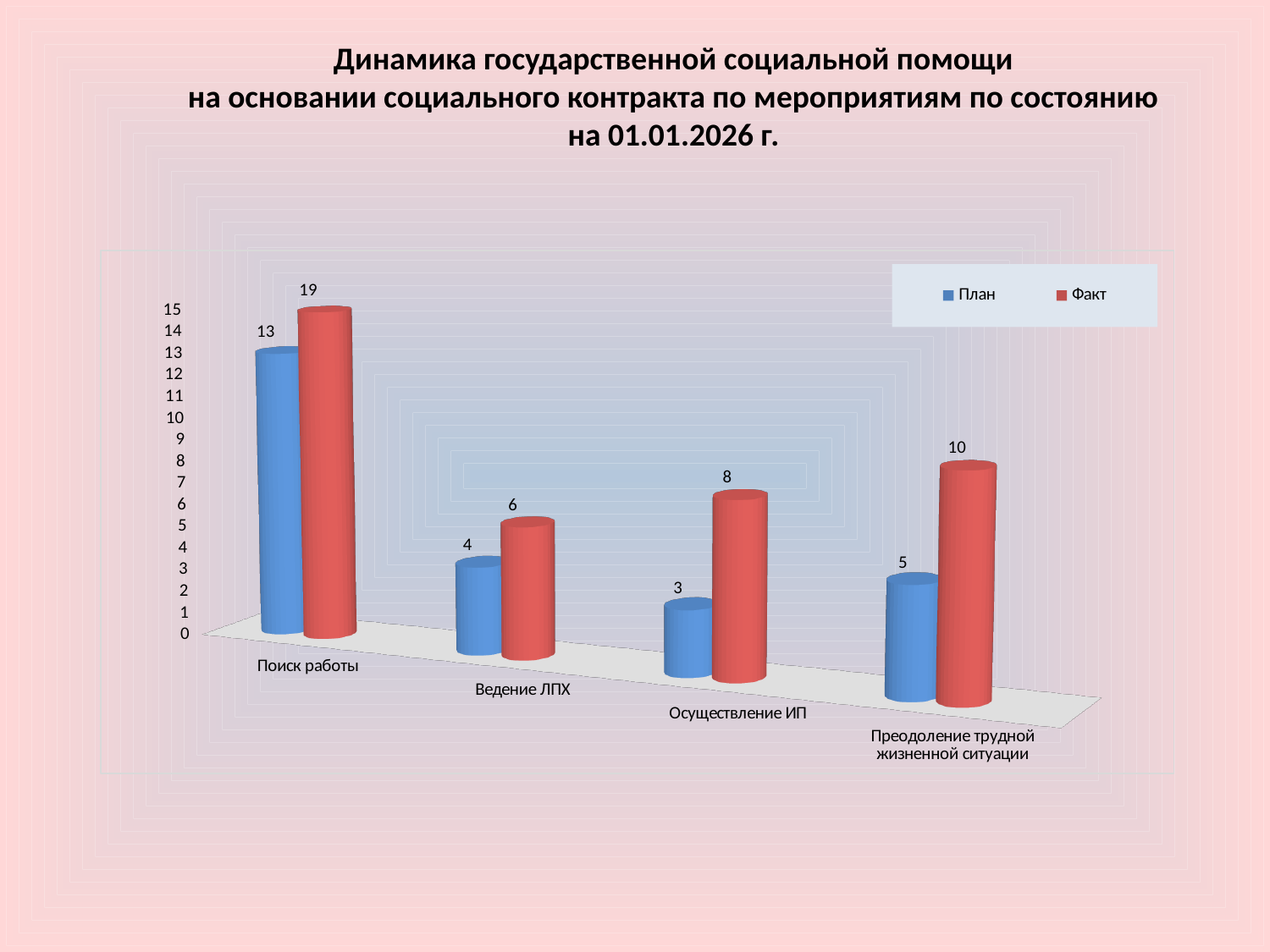
What is the Факт value for Ведение ЛПХ? 6 How many categories are shown on the x axis? 4 Which category has the lowest План value? Осуществление ИП What kind of chart is shown on the slide? Bar chart What is the План value for Поиск работы? 13 Which is larger for Преодоление трудной жизненной ситуации, План or Факт? Факт Which category has the highest Факт value? Поиск работы What is the Факт value for Преодоление трудной жизненной ситуации? 10 What is the difference between the Факт and План values for Поиск работы? 6 What is the План value for Осуществление ИП? 3 How many series does the legend list? 2 What is the Факт value for Поиск работы? 19